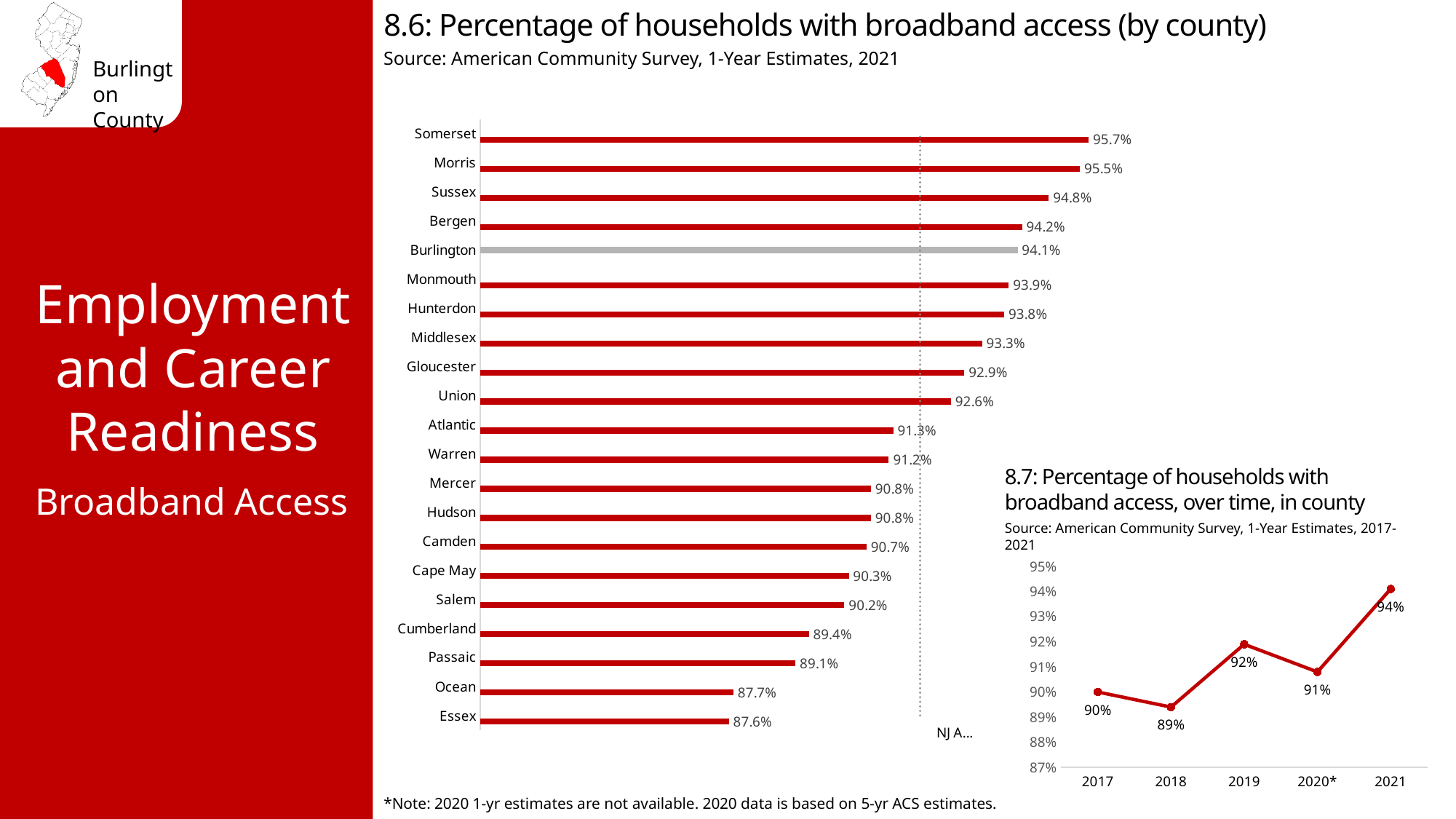
In the chart '8.6: Percentage of households with broadband access (by county)', which bar is shown in grey rather than red? Burlington In the chart '8.6: Percentage of households with broadband access (by county)', how many counties are shown? 21 In the chart '8.6: Percentage of households with broadband access (by county)', what is the value for Burlington? 94.1% In the chart '8.6: Percentage of households with broadband access (by county)', which county has the highest percentage? Somerset In the chart '8.6: Percentage of households with broadband access (by county)', what is the difference between Somerset and Essex? 8.1% What kind of chart is '8.6: Percentage of households with broadband access (by county)'? Bar chart In the chart '8.6: Percentage of households with broadband access (by county)', which is larger, Gloucester or Passaic? Gloucester In the chart '8.6: Percentage of households with broadband access (by county)', what is the value for Cumberland? 89.4% In the chart '8.6: Percentage of households with broadband access (by county)', which county has the lowest percentage? Essex In the chart '8.7: Percentage of households with broadband access, over time, in county', which year has the lowest value? 2018 In the chart '8.7: Percentage of households with broadband access, over time, in county', how many data points are plotted? 5 In the chart '8.7: Percentage of households with broadband access, over time, in county', what is the value for 2019? 92%